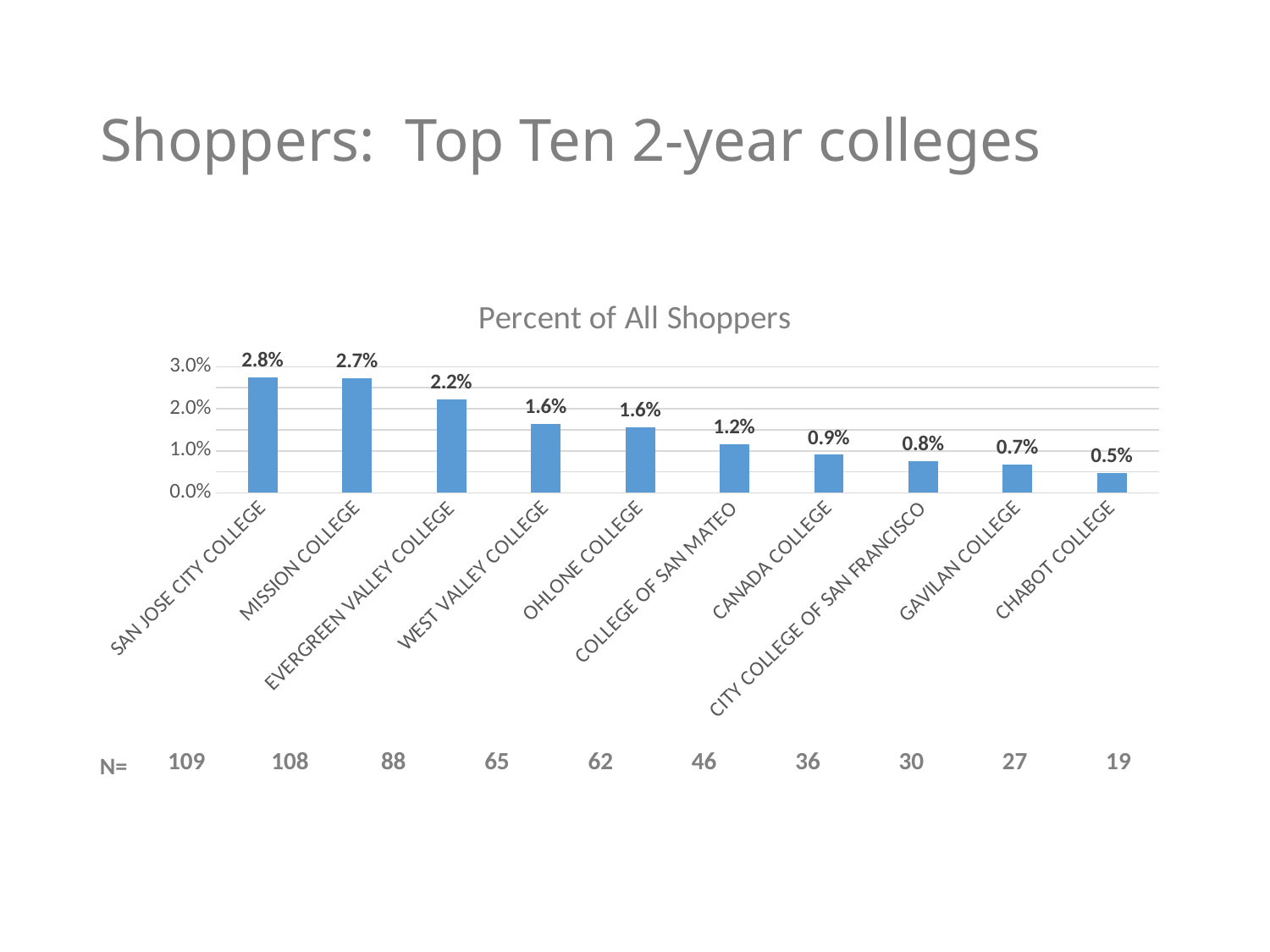
What is the value for Canada College? 0.9% Do the values rise or fall from left to right along the x axis? fall How many colleges are shown in the chart? 10 What is the difference between the values for Mission College and West Valley College? 1.1% What is the value for Evergreen Valley College? 2.2% What is the title of the chart? Percent of All Shoppers Is the value for Ohlone College greater or less than 1.0%? greater What kind of chart is shown on the slide? bar chart Which is larger, the value for College of San Mateo or the value for Gavilan College? College of San Mateo Which college has the highest percent of all shoppers? San Jose City College Which college has the lowest percent of all shoppers? Chabot College What is the value for San Jose City College? 2.8%